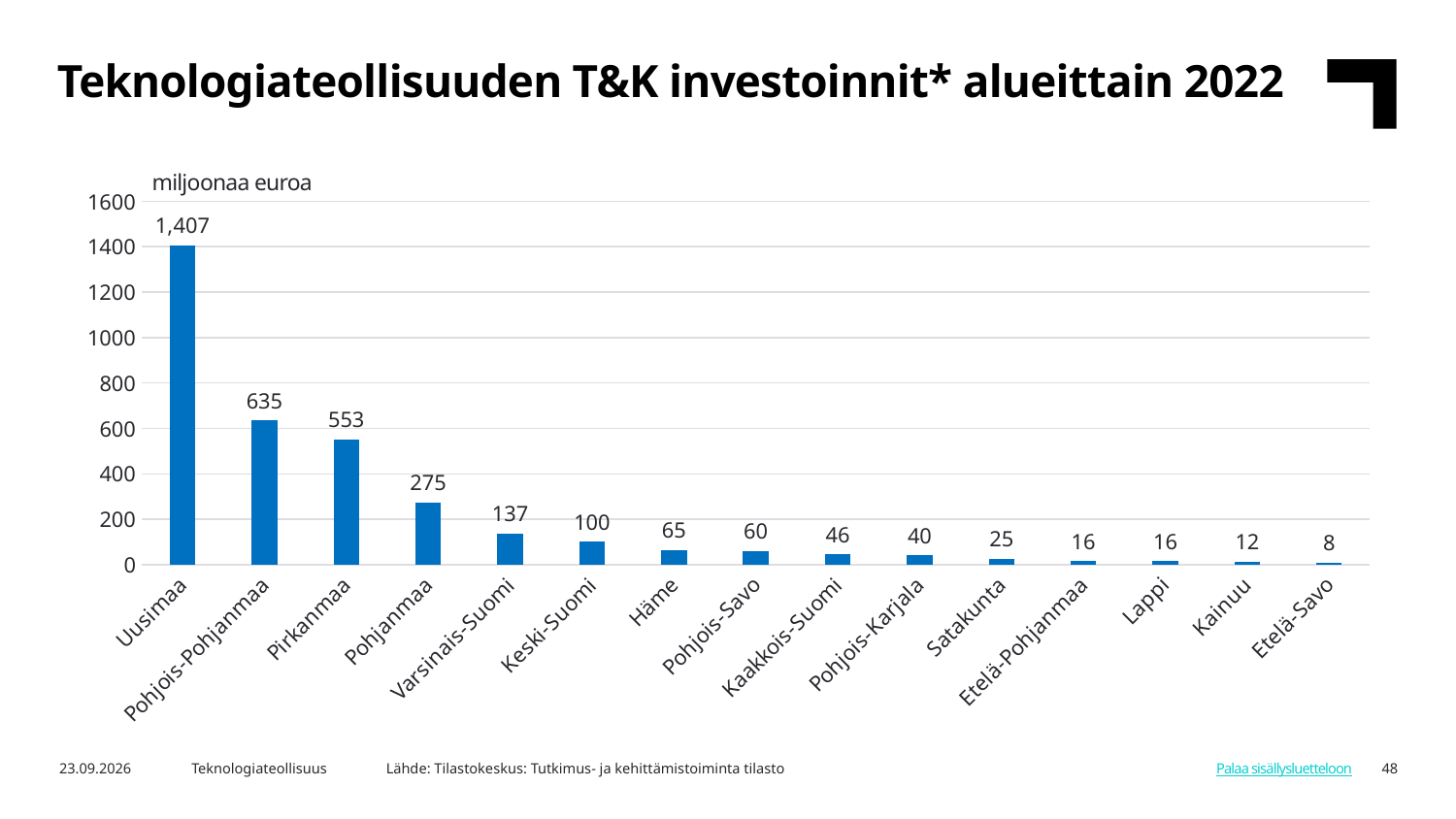
Which is larger, the value for Häme or the value for Pohjois-Savo? Häme What kind of chart is shown on the slide? Bar chart Is the value for Pohjois-Pohjanmaa greater or less than 600? greater What is the value for Satakunta? 25 Which region has the lowest value? Etelä-Savo Which region has the highest value? Uusimaa How many regions are shown on the x axis? 15 What is the difference between the values for Pohjanmaa and Keski-Suomi? 175 What is the difference between the values for Uusimaa and Pohjois-Pohjanmaa? 772 What is the value for Pirkanmaa? 553 What is the value for Varsinais-Suomi? 137 What unit is shown above the y axis of the chart? miljoonaa euroa